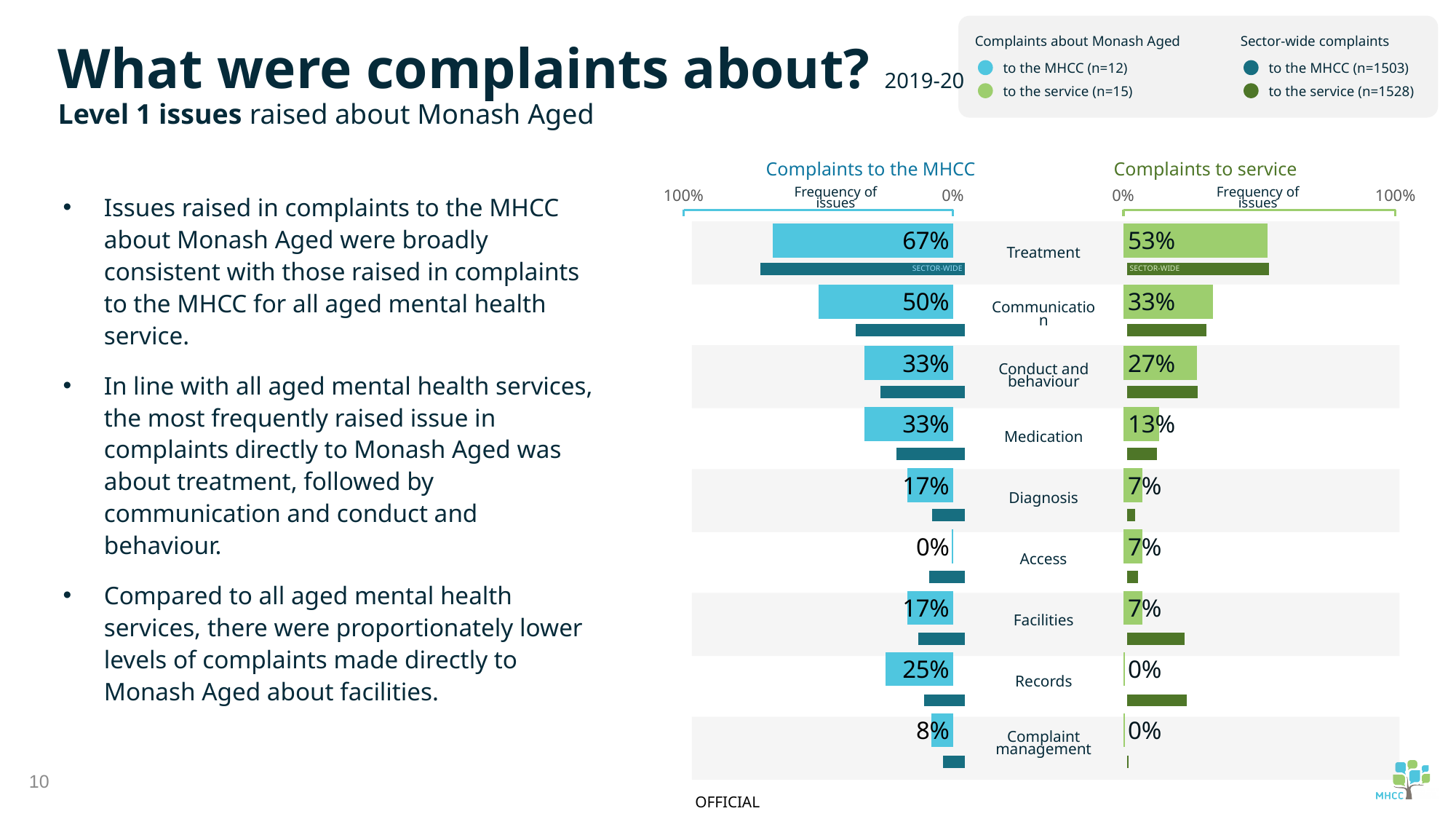
According to the legend, how many complaints about Monash Aged were made to the service? n=15 How many issue categories are shown in the 'Complaints to the MHCC' chart? 9 In the 'Complaints to service' chart, what is the value for Medication? 13% In the 'Complaints to the MHCC' chart, which issue has the lowest frequency? Access In the 'Complaints to the MHCC' chart, what percentage of complaints raised Treatment as an issue? 67% In the 'Complaints to the MHCC' chart, which issue has the highest frequency? Treatment In the 'Complaints to service' chart, which issue has the highest frequency? Treatment What is the difference between the Treatment values in the 'Complaints to the MHCC' chart and the 'Complaints to service' chart? 14% In the 'Complaints to service' chart, what is the value for Communication? 33% In the 'Complaints to the MHCC' chart, what is the value for Records? 25% In the 'Complaints to the MHCC' chart, which is larger: the value for Communication or the value for Conduct and behaviour? Communication What type of chart is used to show 'Complaints to service'? Bar chart